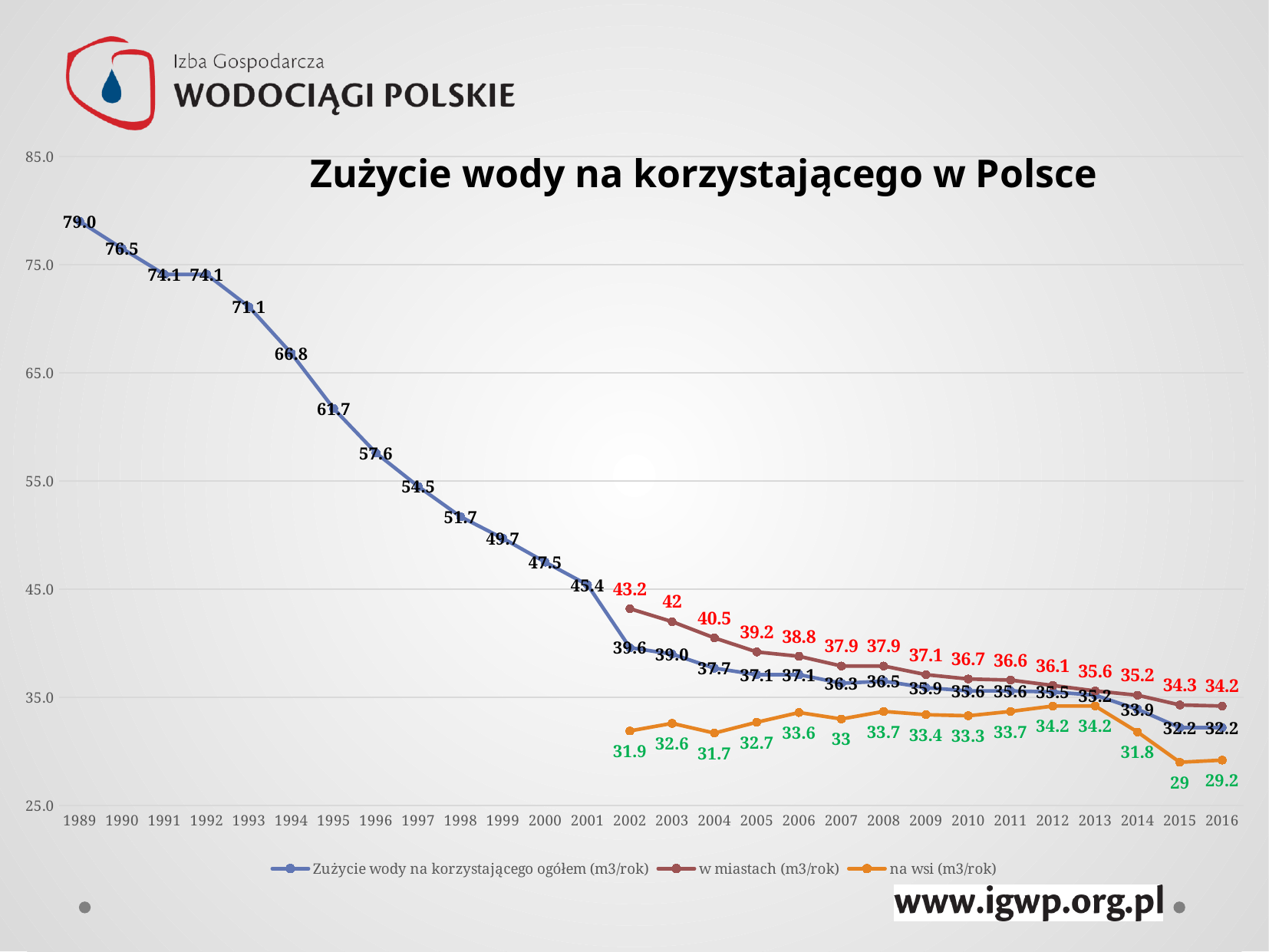
What kind of chart is shown on the slide? Line chart What is the difference between the 'w miastach (m3/rok)' value and the 'na wsi (m3/rok)' value in 2016? 5.0 What is the title of the chart? Zużycie wody na korzystającego w Polsce Does the 'Zużycie wody na korzystającego ogółem (m3/rok)' series generally rise or fall from 1989 to 2016? Fall Which is larger in 2002: the 'w miastach (m3/rok)' value or the 'na wsi (m3/rok)' value? w miastach (m3/rok) In which year is the 'na wsi (m3/rok)' series at its lowest? 2015 What is the value of the 'w miastach (m3/rok)' series in 2004? 40.5 What is the value of the 'Zużycie wody na korzystającego ogółem (m3/rok)' series in 1989? 79.0 How many years are shown on the x axis? 28 In which year is the 'w miastach (m3/rok)' series at its highest? 2002 What is the value of the 'na wsi (m3/rok)' series in 2015? 29 How many series does the legend list? 3